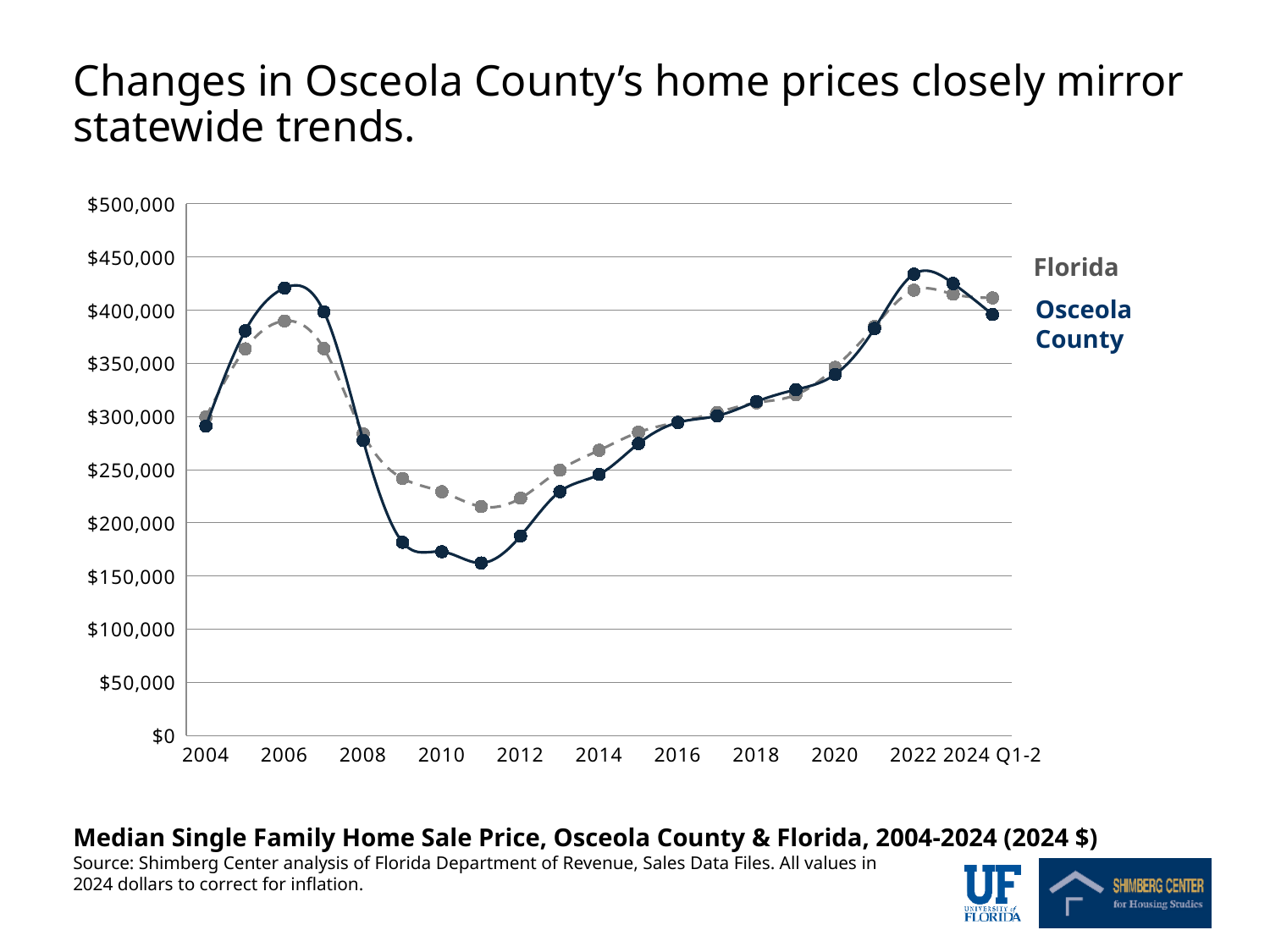
Is the Florida value for 2006 greater or less than $350,000? greater What kind of chart is shown on the slide? Line chart In which year does the Osceola County series reach its lowest value? 2011 In 2006, which series has the higher value, Florida or Osceola County? Osceola County In 2010, which series has the higher value, Florida or Osceola County? Florida Between 2006 and 2011, does the Osceola County series rise or fall? Fall Is the Osceola County value for 2011 greater or less than $200,000? less What is the title of the chart? Median Single Family Home Sale Price, Osceola County & Florida, 2004-2024 (2024 $) In which year does the Osceola County series reach its highest value? 2022 How many series does the chart's legend list? 2 Which two series are plotted on the chart? Florida and Osceola County Is the Osceola County value for 2022 greater or less than $400,000? greater